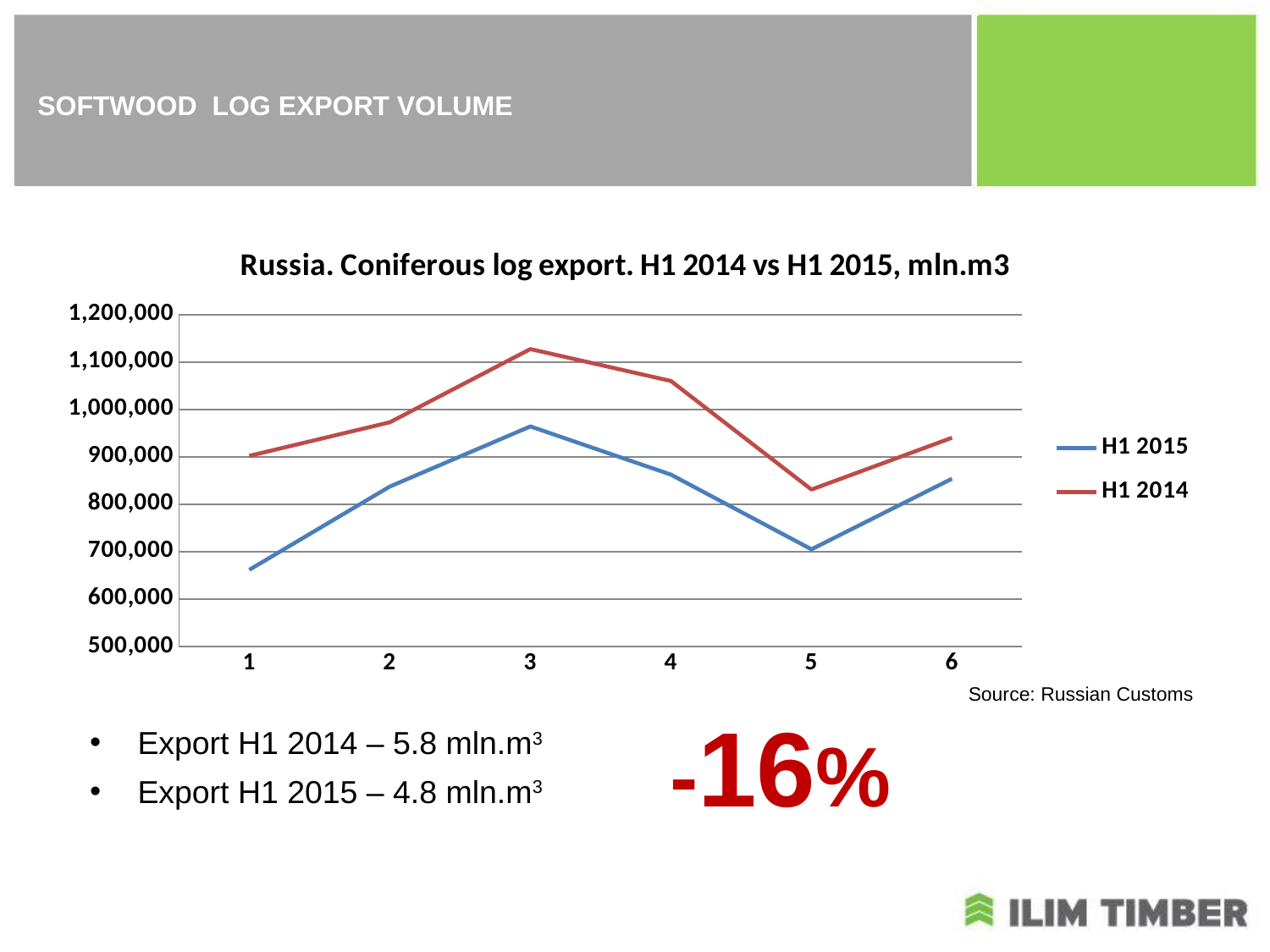
At which x-axis point does the H1 2014 series reach its highest value? 3 At point 3, which series has the larger value, H1 2014 or H1 2015? H1 2014 How many points are plotted along the x axis for each series? 6 At which x-axis point is the H1 2014 series lowest? 5 What kind of chart is shown on the slide? line chart What is the title of the chart? Russia. Coniferous log export. H1 2014 vs H1 2015, mln.m3 Is the H1 2014 value at point 3 greater or less than 1,100,000? greater Does the H1 2014 series rise or fall from point 3 to point 5? fall How many series does the legend list? 2 At which x-axis point does the H1 2015 series reach its highest value? 3 At which x-axis point is the H1 2015 series lowest? 1 Is the H1 2015 value at point 1 greater or less than 700,000? less